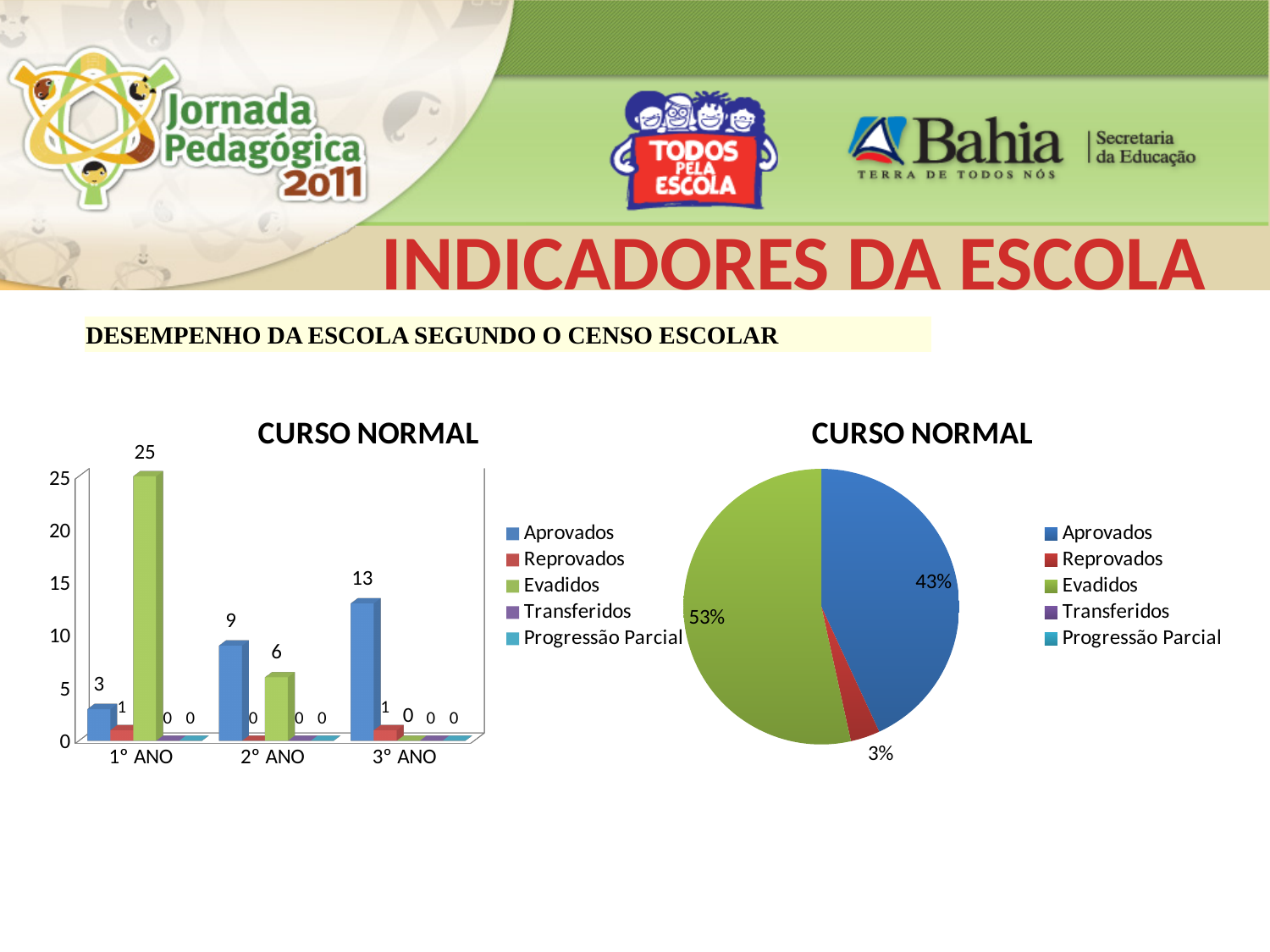
In the bar chart on the left, which year has the highest value for Aprovados? 3° ANO How many categories are shown on the x axis of the bar chart on the left? 3 In the pie chart on the right, what share does Evadidos have? 53% In the bar chart on the left, what is the value for Evadidos in 1° ANO? 25 How many series does the legend of the bar chart on the left list? 5 In the pie chart on the right, what share does Reprovados have? 3% In the bar chart on the left, what is the value for Aprovados in 3° ANO? 13 In the bar chart on the left, which is larger: Aprovados in 1° ANO or Evadidos in 1° ANO? Evadidos in 1° ANO In the bar chart on the left, what is the difference between Evadidos in 1° ANO and Evadidos in 2° ANO? 19 What kind of chart is the chart on the left? bar chart In the pie chart on the right, which slice is the largest? Evadidos In the bar chart on the left, what is the value for Aprovados in 2° ANO? 9